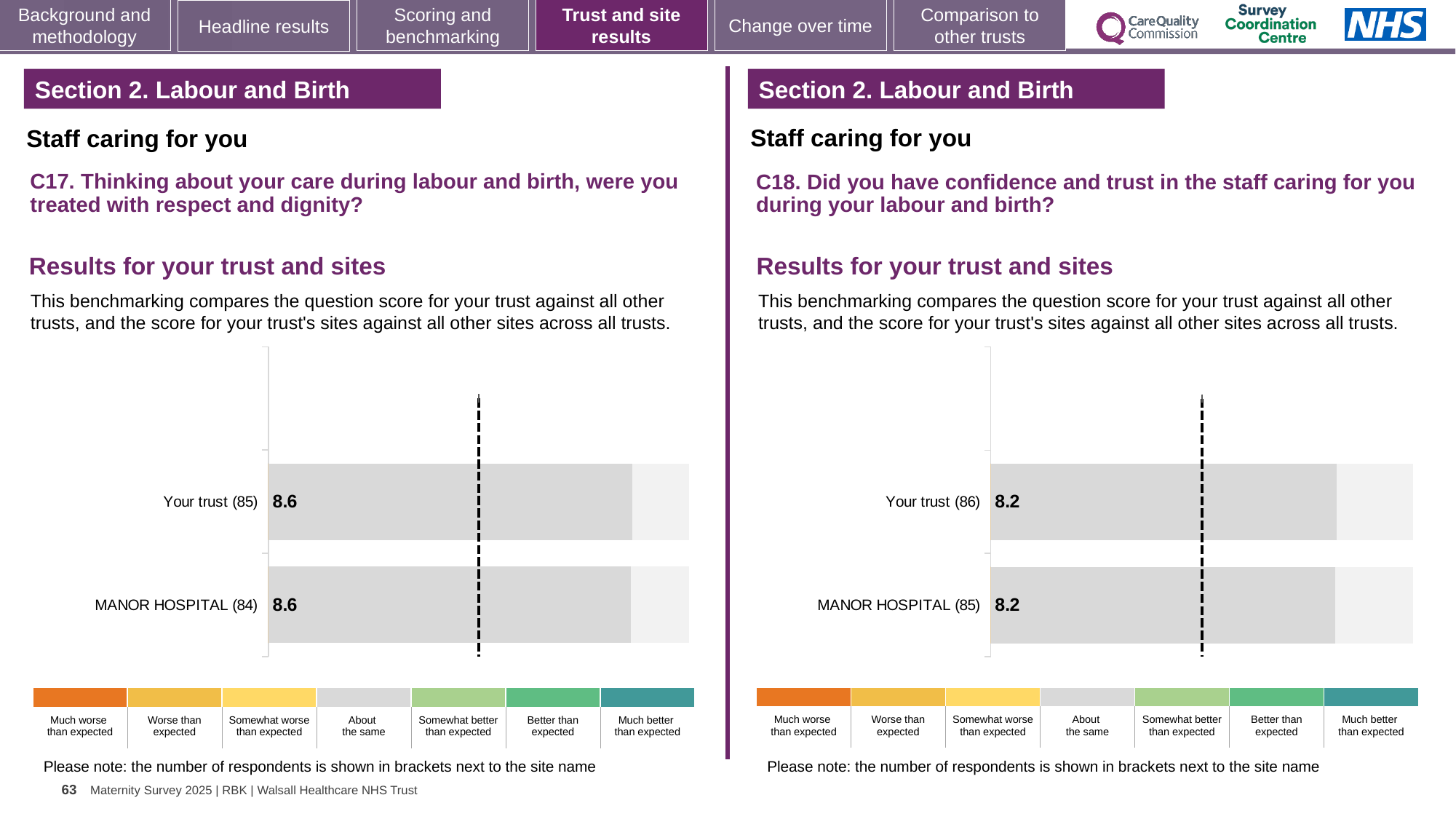
In the C17 chart on the left, what is the score for MANOR HOSPITAL? 8.6 What is the difference between the MANOR HOSPITAL score in the C17 chart on the left and the MANOR HOSPITAL score in the C18 chart on the right? 0.4 What kind of chart is used in the C18 chart on the right? Bar chart How many bars are plotted in the C18 chart on the right? 2 In the C18 chart on the right, what is the score for MANOR HOSPITAL? 8.2 In the C18 chart on the right, how many respondents are shown in brackets for Your trust? 86 In the C17 chart on the left, how many respondents are shown in brackets for MANOR HOSPITAL? 84 In the C17 chart on the left, what is the score for Your trust? 8.6 According to the colour key below the C17 chart on the left, which benchmark category does the grey bar colour represent? About the same Which is larger: the Your trust score in the C17 chart on the left or the Your trust score in the C18 chart on the right? C17 (8.6) In the C18 chart on the right, what is the score for Your trust? 8.2 How many bars are plotted in the C17 chart on the left? 2